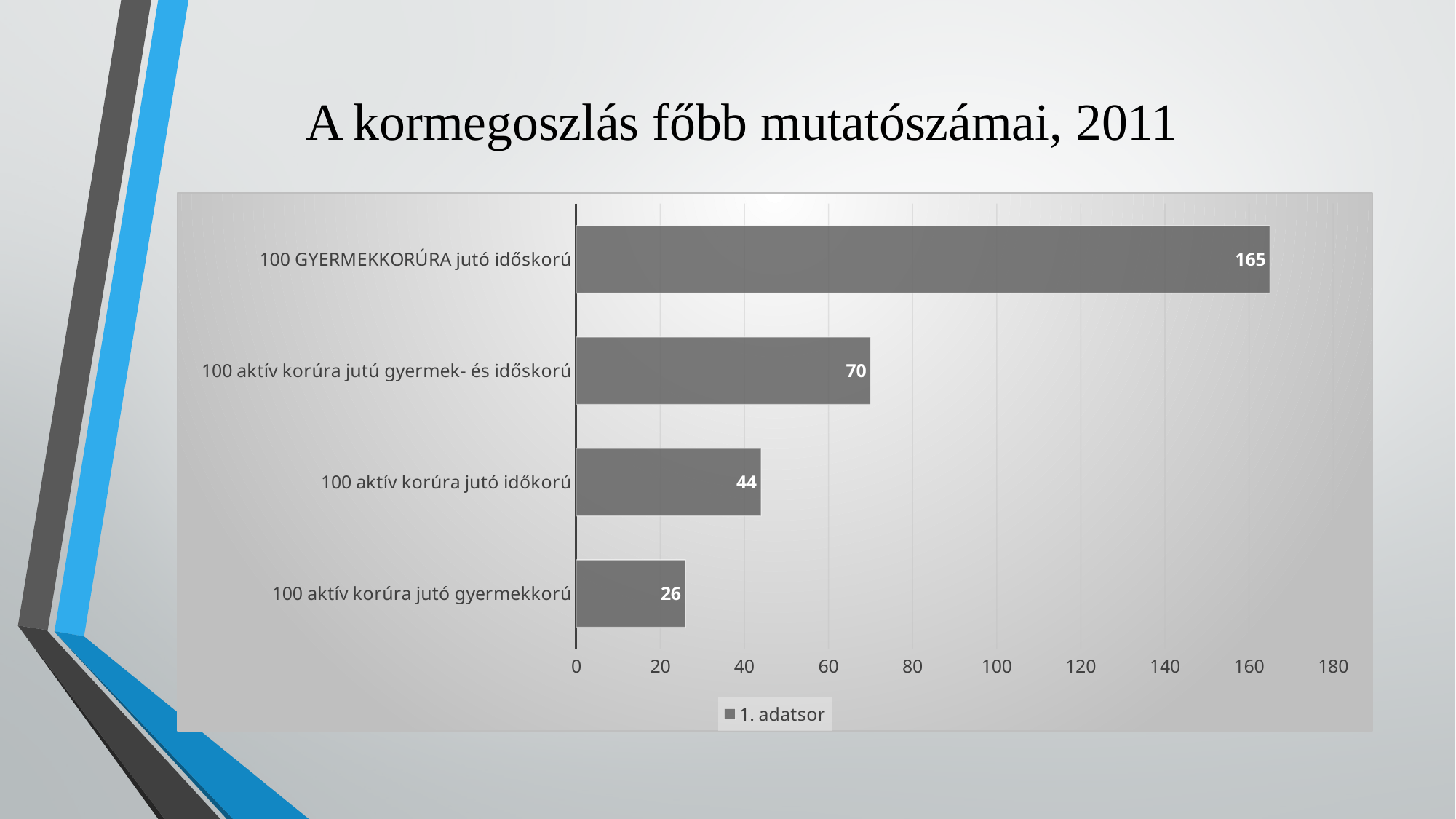
How many series does the legend list? 1 What is the value for "100 GYERMEKKORÚRA jutó időskorú"? 165 What is the value for "100 aktív korúra jutó gyermekkorú"? 26 What is the title of the slide? A kormegoszlás főbb mutatószámai, 2011 Which category has the highest value? 100 GYERMEKKORÚRA jutó időskorú What is the value for "100 aktív korúra jutó időkorú"? 44 Which category has the lowest value? 100 aktív korúra jutó gyermekkorú How many categories are shown in the chart? 4 What kind of chart is shown on the slide? Bar chart Which is larger: the value for "100 aktív korúra jutó időkorú" or the value for "100 aktív korúra jutó gyermekkorú"? 100 aktív korúra jutó időkorú What is the value for "100 aktív korúra jutú gyermek- és időskorú"? 70 What is the difference between the values for "100 aktív korúra jutú gyermek- és időskorú" and "100 aktív korúra jutó gyermekkorú"? 44